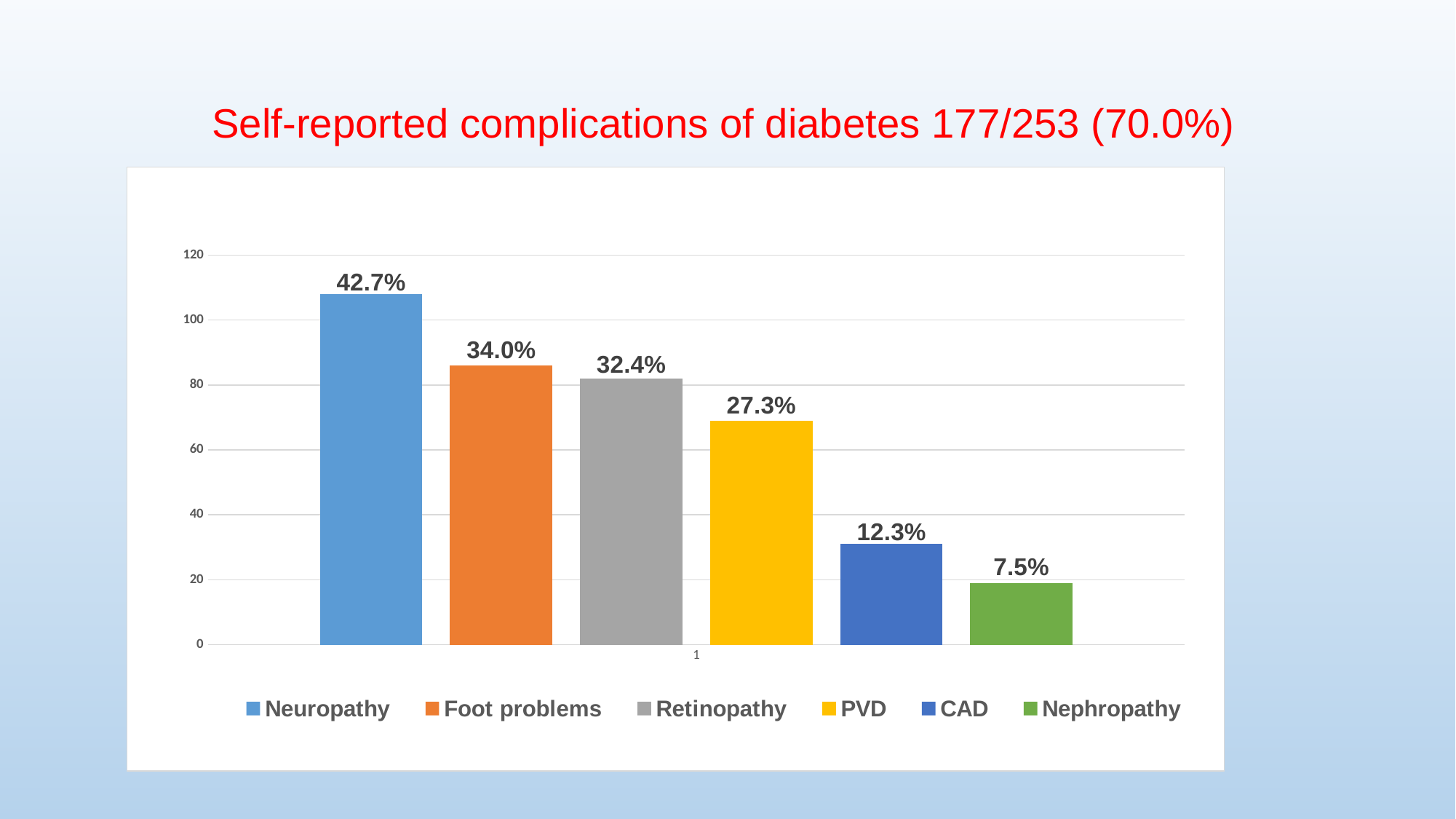
What is the difference between the labelled percentages for Foot problems and Retinopathy? 1.6% How many complications are plotted in the chart? 6 Is the bar for Neuropathy greater or less than 100 on the vertical axis? greater What kind of chart is shown on the slide? Bar chart Which complication has the highest bar? Neuropathy What is the data label shown for Nephropathy? 7.5% What colour is the bar for Retinopathy? Grey What is the data label shown for PVD? 27.3% What is the data label shown for Neuropathy? 42.7% Which has a larger bar, CAD or PVD? PVD Which complication has the lowest bar? Nephropathy